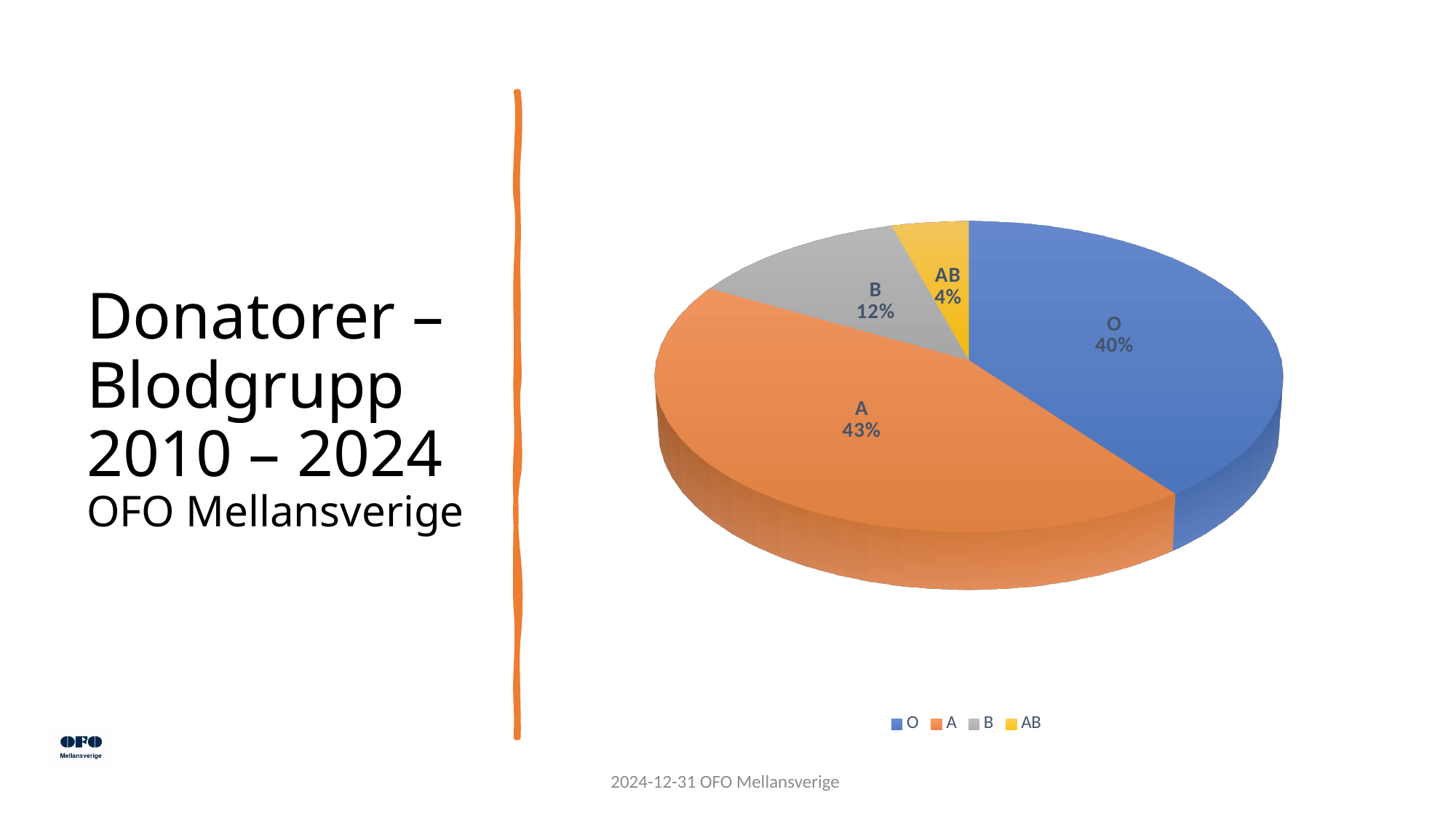
What share of donors has blood group A? 43% What share of donors has blood group AB? 4% What colour is the slice for blood group AB? Yellow Which blood group has the largest share of donors? A How many blood groups are shown in the pie chart? 4 What kind of chart is shown on the slide? Pie chart What is the difference in percentage points between blood group A and blood group O? 3 Which blood group has the smallest share of donors? AB What is the difference in percentage points between blood group B and blood group AB? 8 Which has a larger share, blood group B or blood group AB? B What share of donors has blood group O? 40% What share of donors has blood group B? 12%